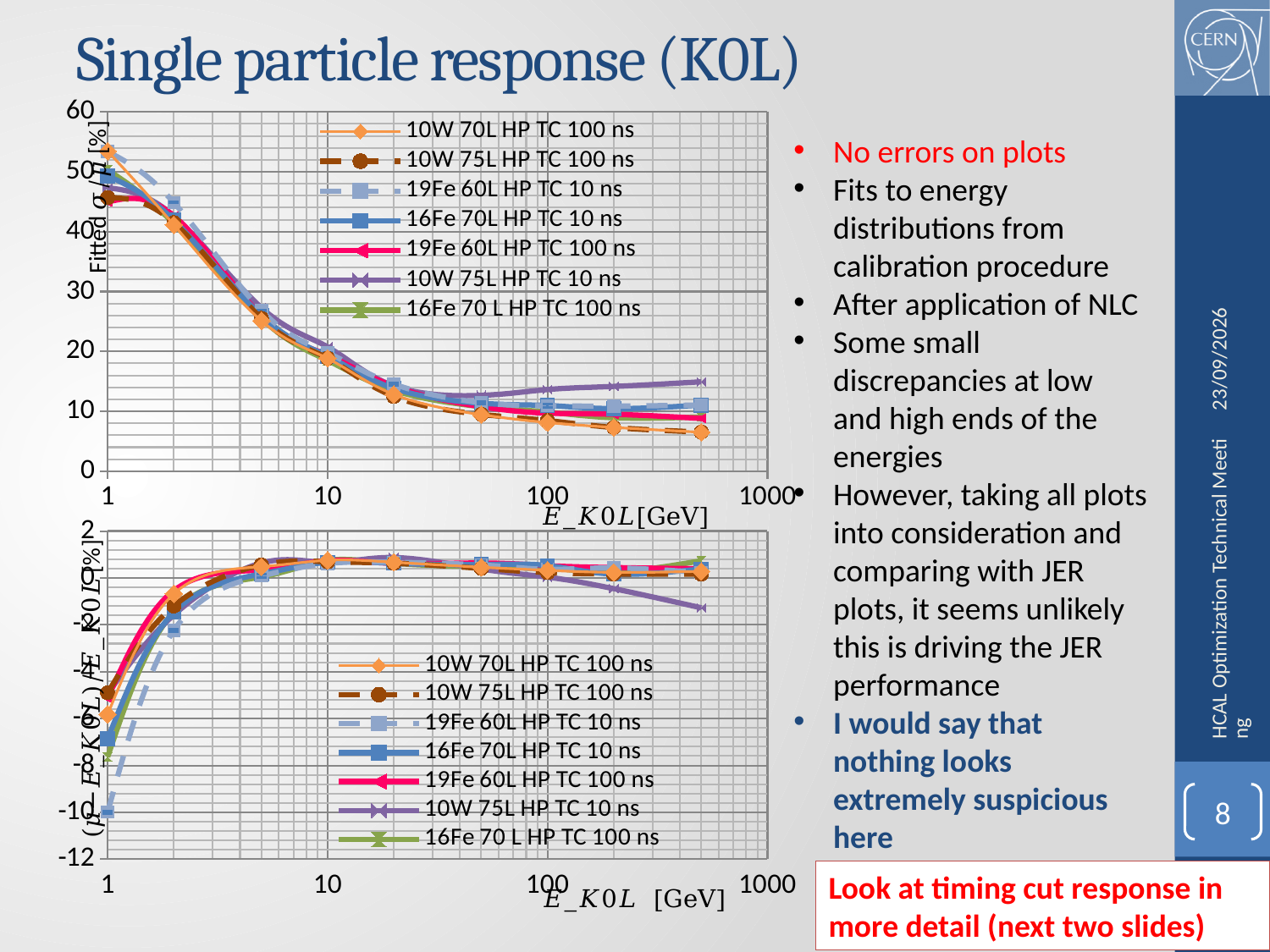
In the top chart, are the values of all series at 10 GeV greater or less than 30? less What is the x-axis label of the bottom chart? E_K0L [GeV] How many series does the legend of the top chart list? 7 What kind of chart is the top chart on the slide? line chart In the bottom chart, which series has the lowest value at the highest energy point? 10W 75L HP TC 10 ns How many series does the legend of the bottom chart list? 7 In the top chart, which series has the highest value at the highest energy point? 10W 75L HP TC 10 ns In the bottom chart, is the value for 19Fe 60L HP TC 10 ns at 1 GeV greater or less than -4? less What is the maximum value shown on the y axis of the top chart? 60 In the top chart, is the value for 10W 75L HP TC 10 ns at the highest energy point greater or less than 10? greater In the top chart, do the values generally rise or fall as E_K0L increases from 1 to 100 GeV? fall